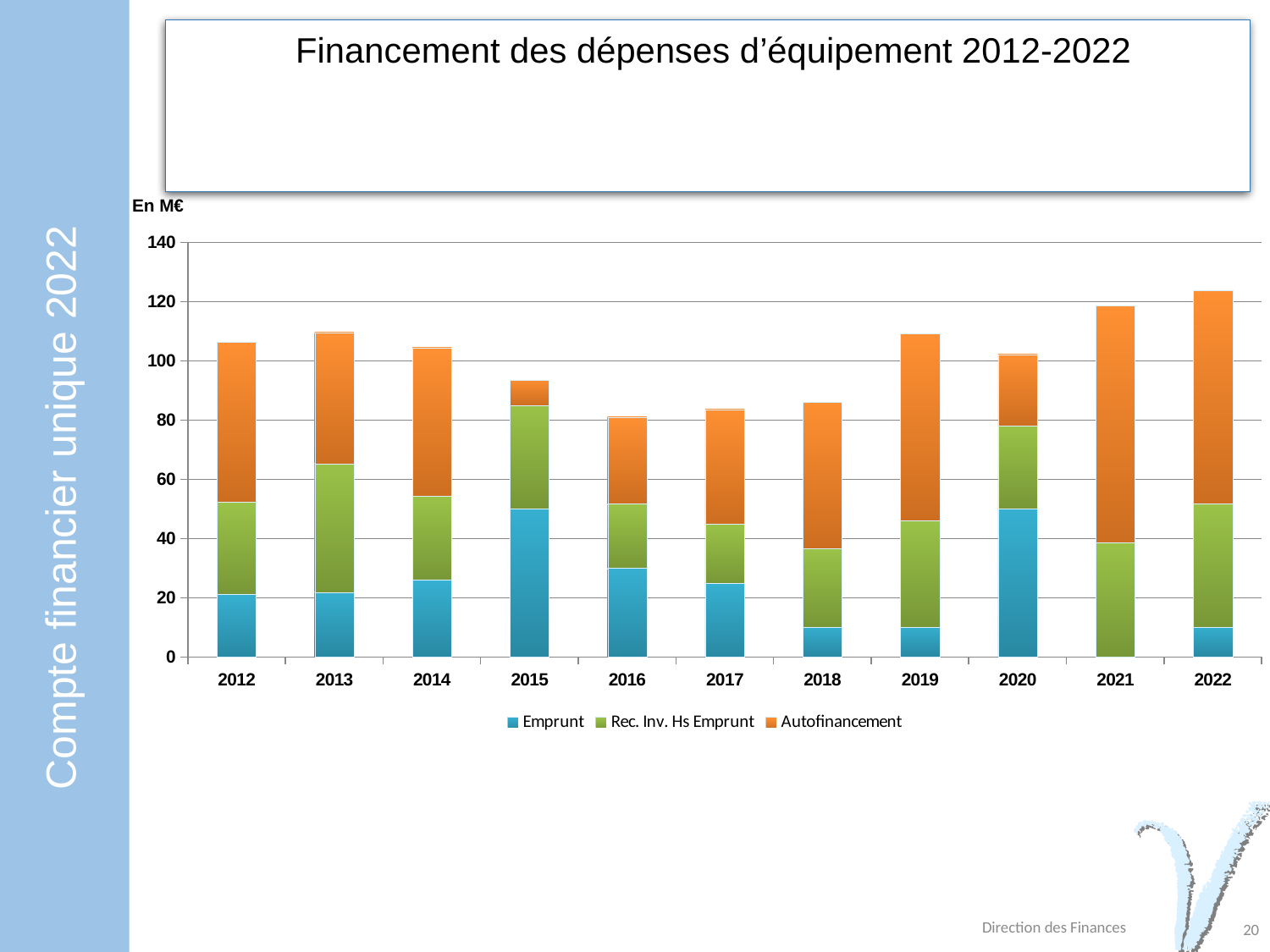
Is the total stacked value for 2022 greater or less than 120? greater Which year has the highest total stacked bar? 2022 How many series does the chart legend list? 3 What unit is indicated above the chart's vertical axis? En M€ Is the Emprunt value for 2015 greater or less than 40? greater What kind of chart is shown on the slide? stacked bar chart How many years are shown on the x axis of the chart? 11 Is the Emprunt value for 2012 greater or less than 40? less Which year has the larger total stacked bar, 2016 or 2022? 2022 Which year has the larger Emprunt value, 2014 or 2018? 2014 Do the total stacked values rise or fall from 2013 to 2016? fall